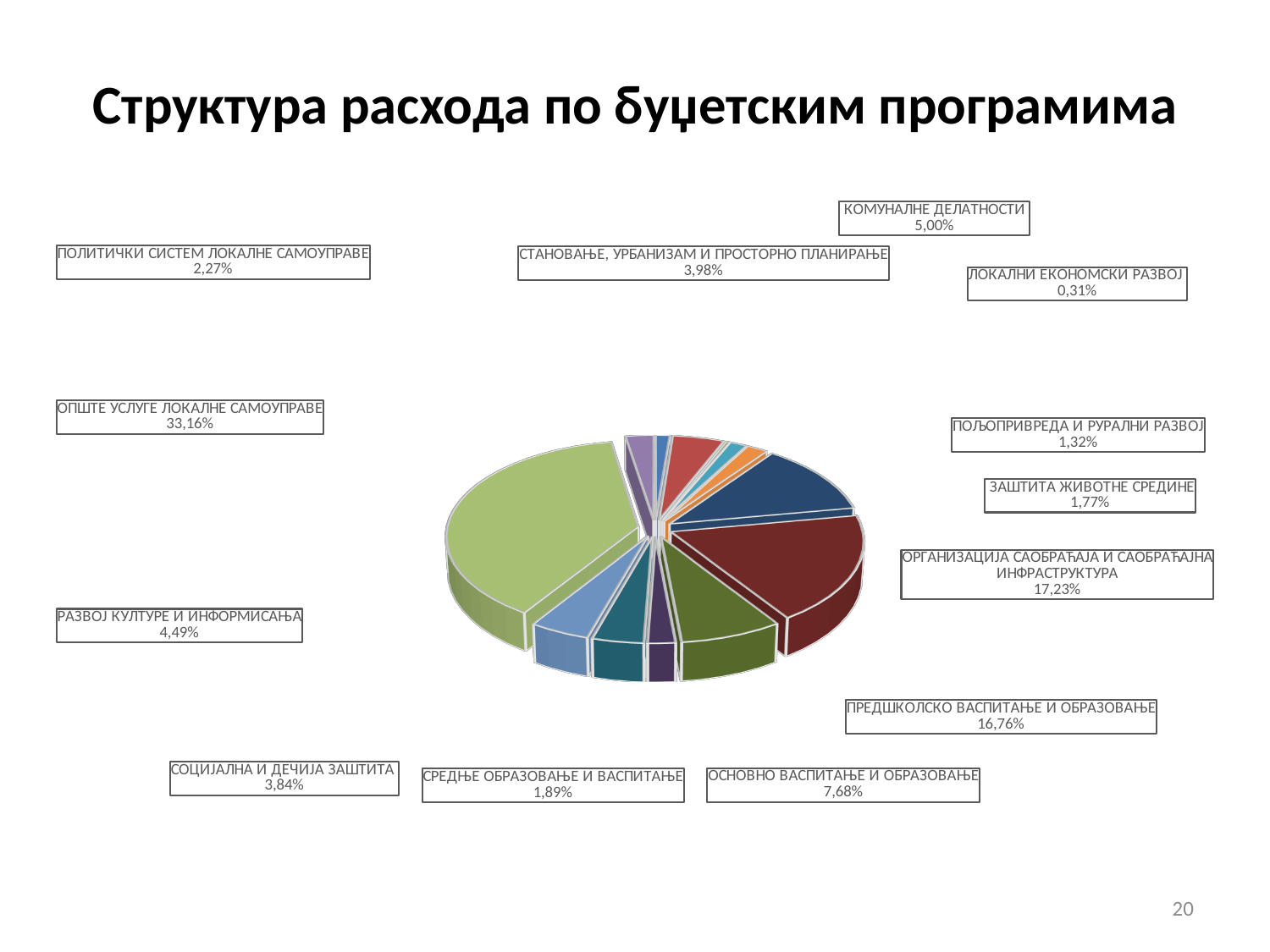
What share does ОПШТЕ УСЛУГЕ ЛОКАЛНЕ САМОУПРАВЕ have in the pie chart? 33,16% How many categories (slices) are labelled in the pie chart? 13 What kind of chart is shown on the slide? Pie chart What is the title of the chart on the slide? Структура расхода по буџетским програмима What is the difference between the shares of ОПШТЕ УСЛУГЕ ЛОКАЛНЕ САМОУПРАВЕ and ОРГАНИЗАЦИЈА САОБРАЋАЈА И САОБРАЋАЈНА ИНФРАСТРУКТУРА? 15,93% What is the difference between the shares of ОРГАНИЗАЦИЈА САОБРАЋАЈА И САОБРАЋАЈНА ИНФРАСТРУКТУРА and ПРЕДШКОЛСКО ВАСПИТАЊЕ И ОБРАЗОВАЊЕ? 0,47% What is the value shown for ЛОКАЛНИ ЕКОНОМСКИ РАЗВОЈ? 0,31% Which category has the largest share of the pie? ОПШТЕ УСЛУГЕ ЛОКАЛНЕ САМОУПРАВЕ Which is larger: ОРГАНИЗАЦИЈА САОБРАЋАЈА И САОБРАЋАЈНА ИНФРАСТРУКТУРА or ПРЕДШКОЛСКО ВАСПИТАЊЕ И ОБРАЗОВАЊЕ? ОРГАНИЗАЦИЈА САОБРАЋАЈА И САОБРАЋАЈНА ИНФРАСТРУКТУРА What is the value shown for ПРЕДШКОЛСКО ВАСПИТАЊЕ И ОБРАЗОВАЊЕ? 16,76% What is the value shown for ОСНОВНО ВАСПИТАЊЕ И ОБРАЗОВАЊЕ? 7,68% Which category has the smallest share of the pie? ЛОКАЛНИ ЕКОНОМСКИ РАЗВОЈ